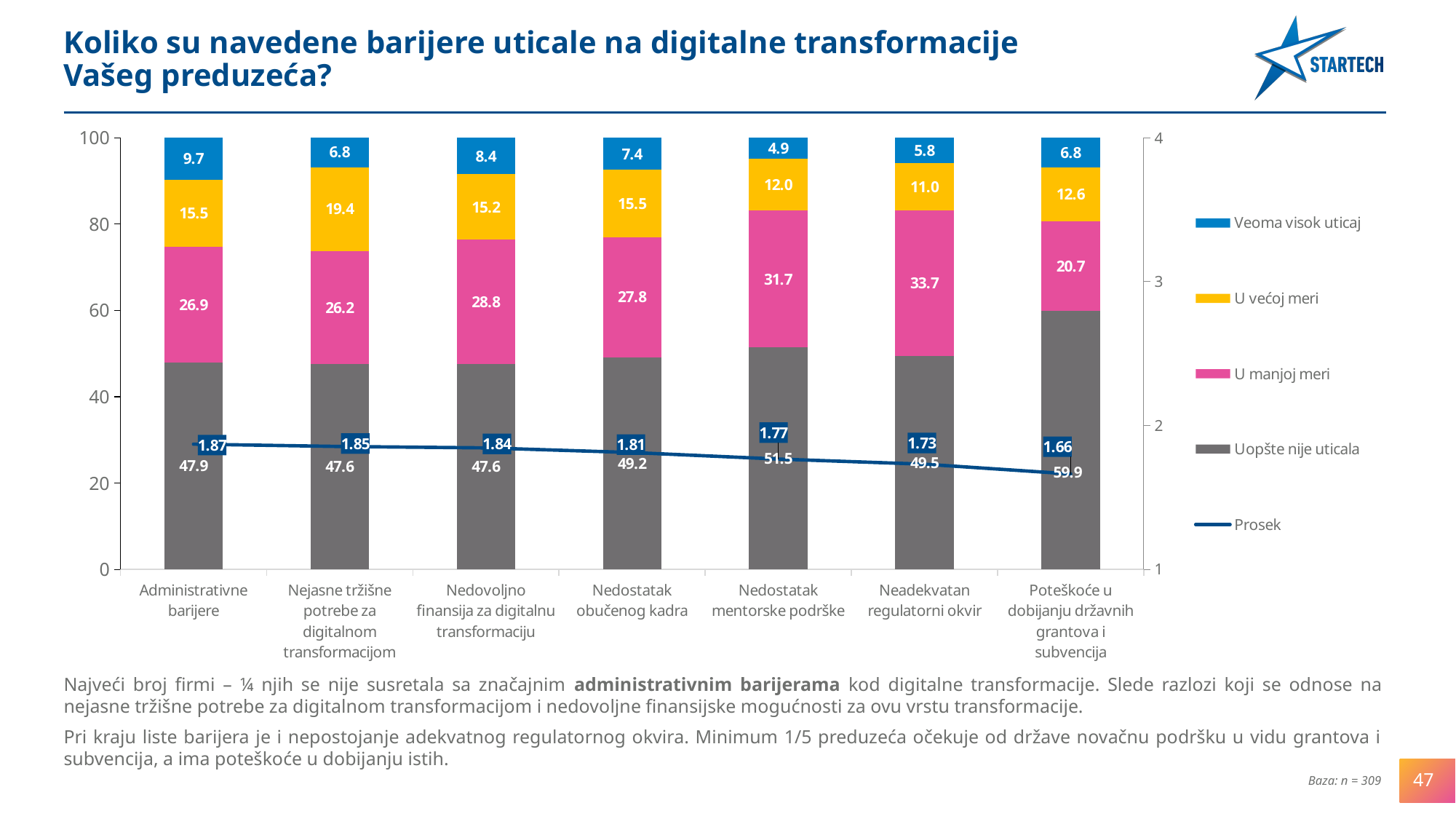
What is the value of 'Veoma visok uticaj' for 'Nedovoljno finansija za digitalnu transformaciju'? 8.4 How many series does the legend list? 5 What is the difference between the 'U većoj meri' values for 'Nejasne tržišne potrebe za digitalnom transformacijom' and 'Administrativne barijere'? 3.9 What is the value of 'Uopšte nije uticala' for 'Poteškoće u dobijanju državnih grantova i subvencija'? 59.9 What is the 'Prosek' value for 'Administrativne barijere'? 1.87 How many categories are shown on the x axis of the chart? 7 What kind of chart is shown on the slide? combination stacked bar and line chart Does the 'Prosek' line rise or fall from left to right across the categories? falls Which category has the lowest value for 'Veoma visok uticaj'? Nedostatak mentorske podrške Which category has the highest 'Prosek' value? Administrativne barijere Which category has the highest value for 'Uopšte nije uticala'? Poteškoće u dobijanju državnih grantova i subvencija Which has a larger 'U manjoj meri' value: 'Neadekvatan regulatorni okvir' or 'Nedostatak mentorske podrške'? Neadekvatan regulatorni okvir